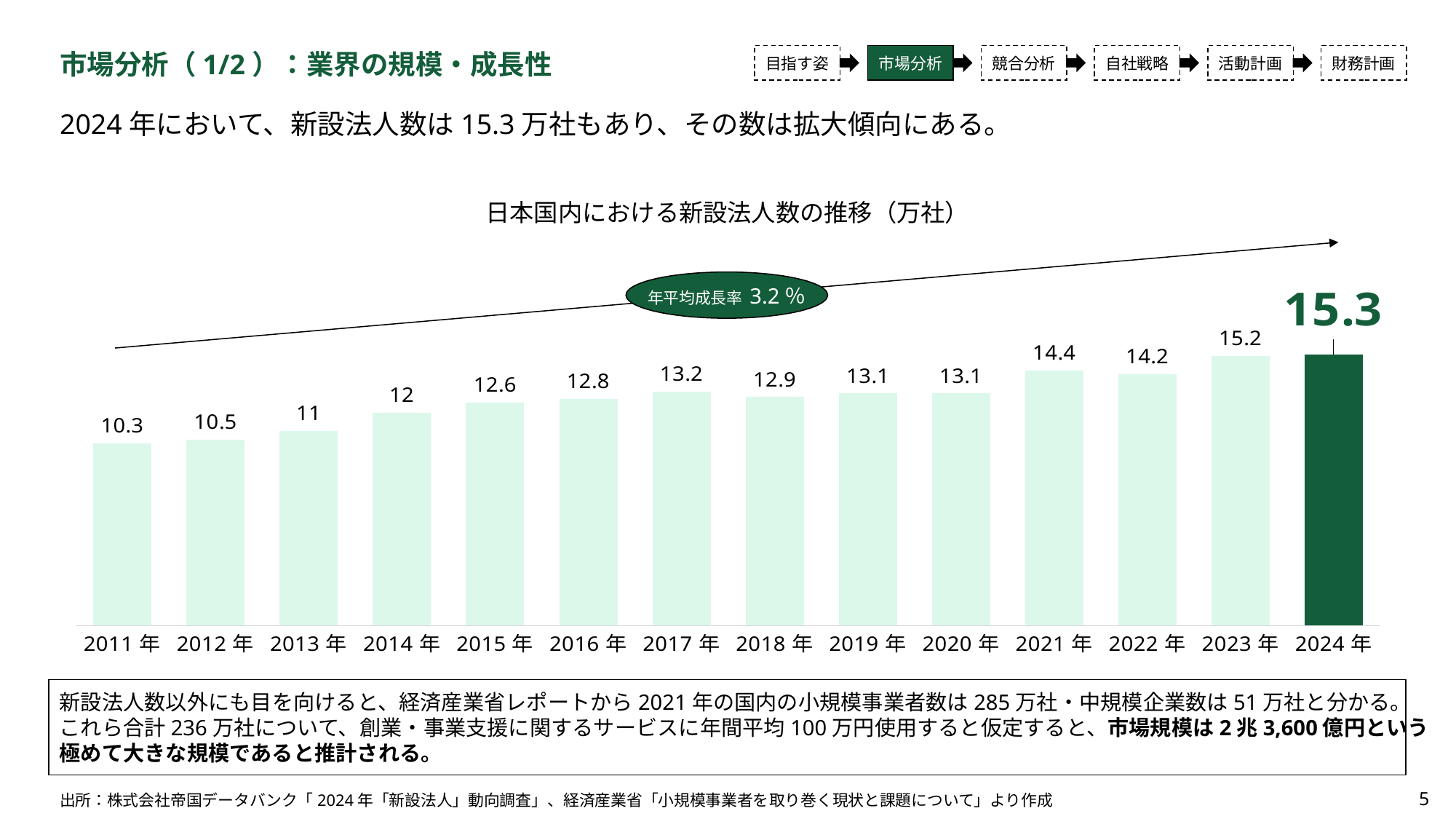
What is the difference between the values for 2024年 and 2011年? 5 Which is larger, the value for 2018年 or the value for 2017年? 2017年 What is the value for 2017年 in the chart? 13.2 What kind of chart is shown on the slide? Bar chart What is the value for 2011年 in the chart? 10.3 Which year has the lowest value in the chart? 2011年 Do the values generally rise or fall from 2011年 to 2024年? Rise How many years are shown on the x axis of the chart? 14 What is the value for 2024年 in the chart? 15.3 What annual average growth rate (年平均成長率) is shown in the oval label on the chart? 3.2% What is the difference between the values for 2021年 and 2022年? 0.2 Which year has the highest value in the chart? 2024年